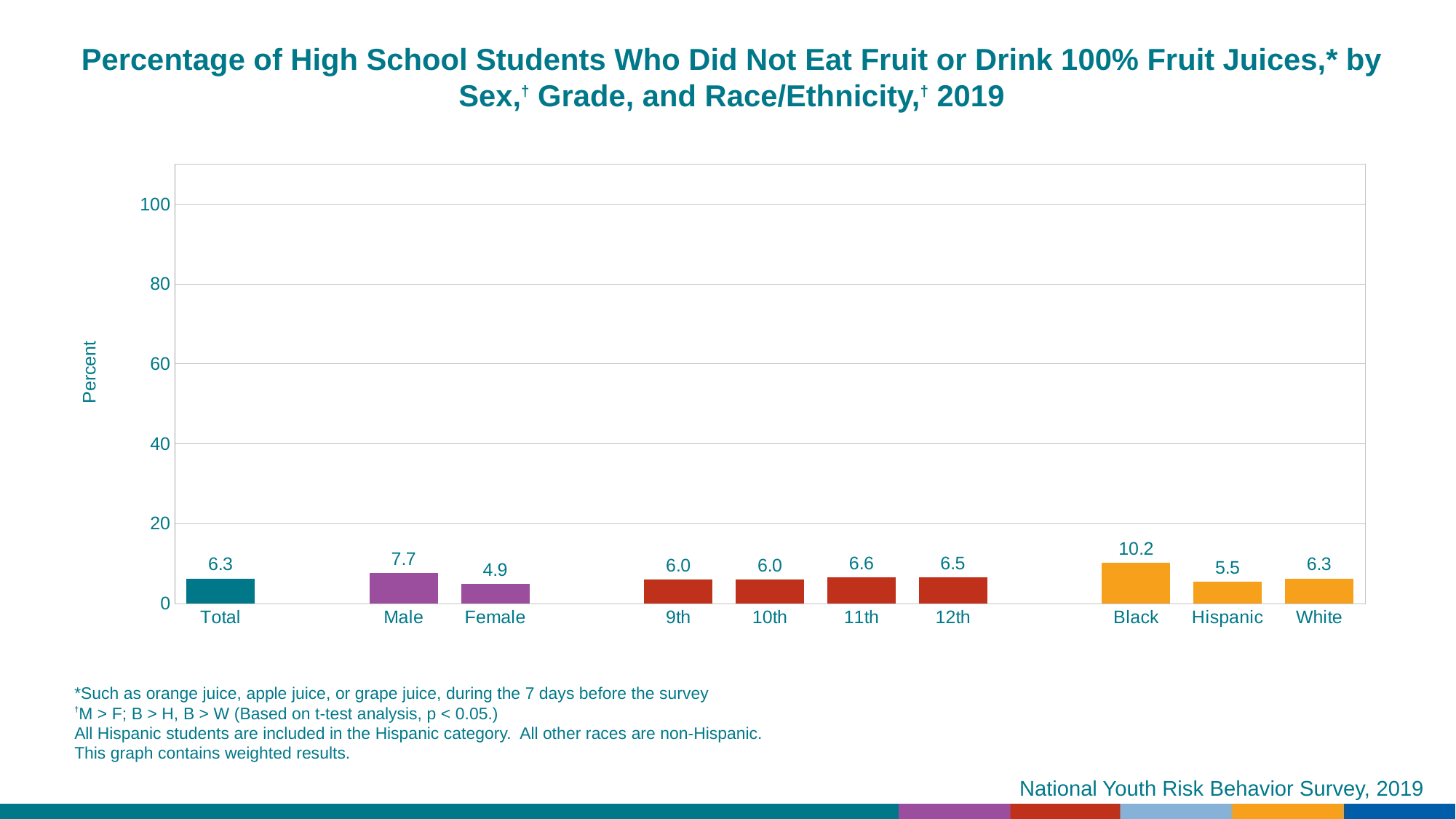
Which is larger, the value for Black or the value for Hispanic? Black Which category has the lowest value? Female What is the value for Black? 10.2 Do the values rise or fall from 9th grade to 11th grade? rise How many categories are shown on the x axis? 10 What is the difference between the values for Male and Female? 2.8 What kind of chart is this? bar chart What is the value for Male? 7.7 What is the label on the y axis? Percent Is the value for Black greater or less than 20? less Which category has the highest value? Black What is the value for Total? 6.3